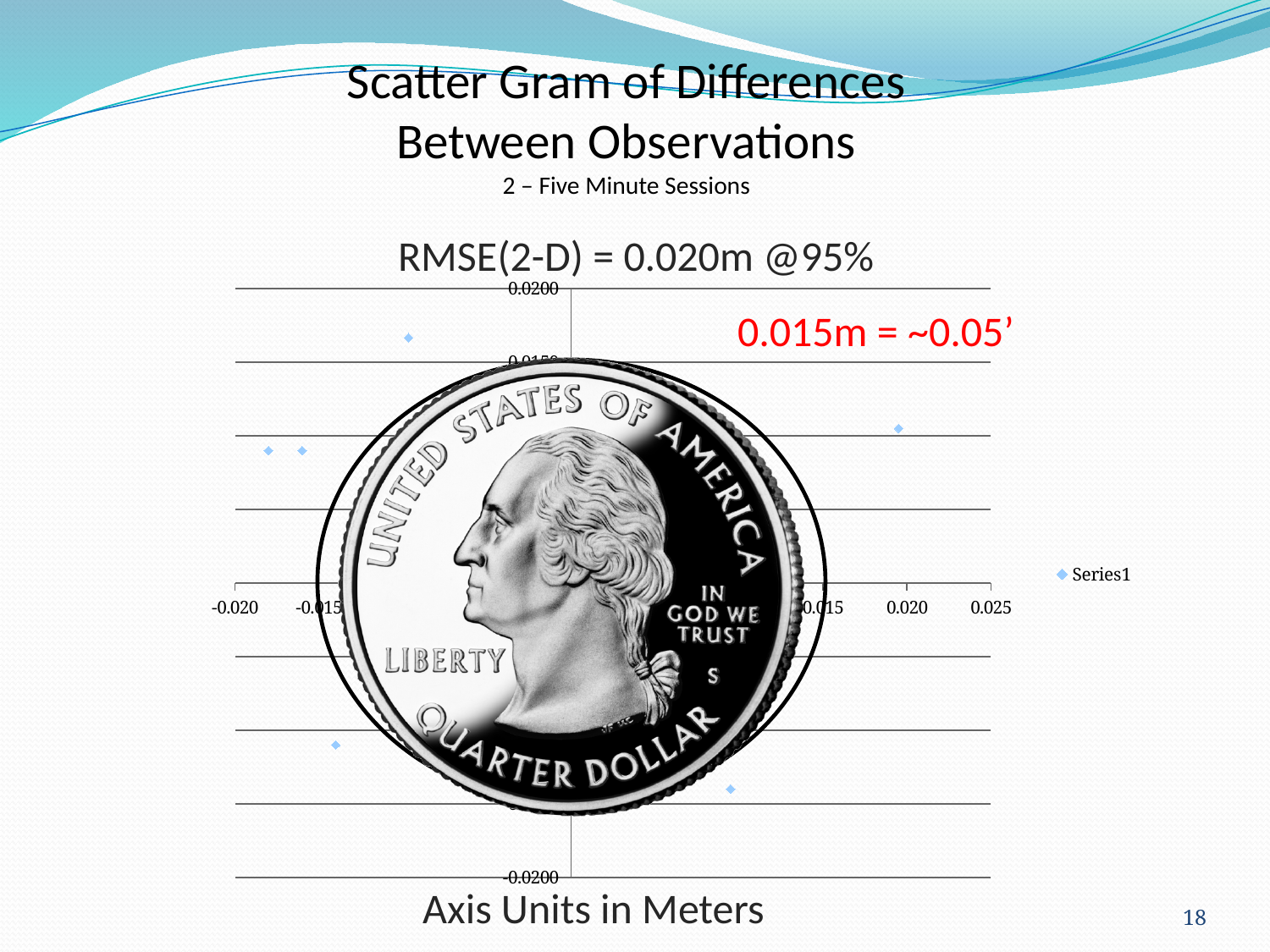
What is the name of the series shown in the chart legend? Series1 How many series does the chart legend list? 1 What kind of chart is shown on the slide? Scatter chart What is the smallest value labelled on the chart's horizontal axis? -0.020 Is the horizontal-axis value of the rightmost plotted point greater or less than 0.015? greater Is the horizontal-axis value of the leftmost plotted point greater or less than -0.015? less What is the lowest value labelled on the chart's vertical axis? -0.0200 Is the vertical-axis value of the highest plotted point greater or less than 0.0100? greater What is the highest value labelled on the chart's vertical axis? 0.0200 What is the largest value labelled on the chart's horizontal axis? 0.025 What is the title of the chart? RMSE(2-D) = 0.020m @95%